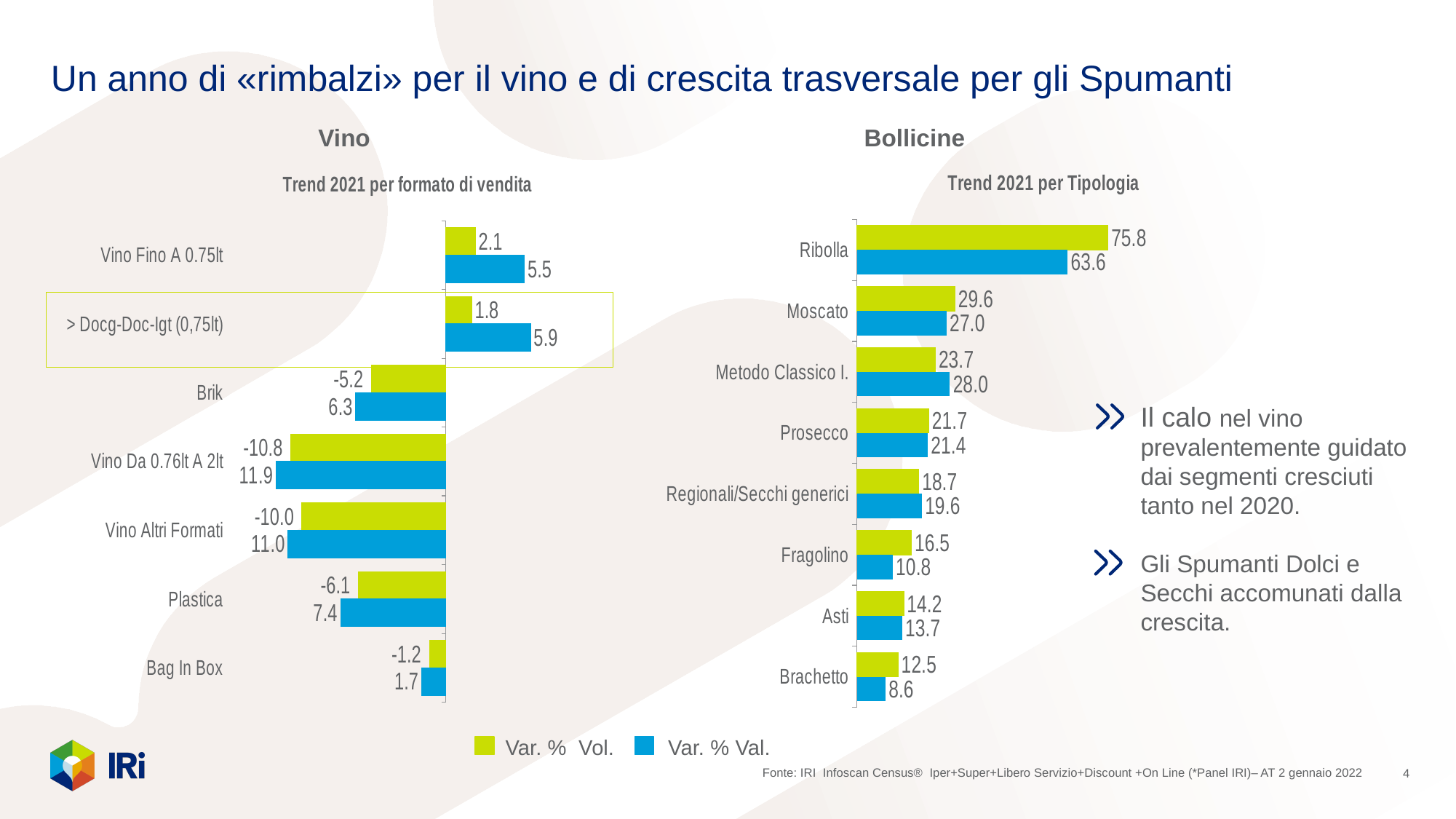
In the Bollicine chart, which is larger for Metodo Classico I.: Var. % Vol. or Var. % Val.? Var. % Val. How many series does the legend list? 2 In the Vino chart (Trend 2021 per formato di vendita), what is the Var. % Vol. value for Brik? -5.2 In the Vino chart, what is the Var. % Val. value for > Docg-Doc-Igt (0,75lt)? 5.9 In the Bollicine chart, what is the difference between the Var. % Vol. and Var. % Val. values for Ribolla? 12.2 How many categories are shown in the Vino chart? 7 In the Bollicine chart (Trend 2021 per Tipologia), what is the Var. % Vol. value for Prosecco? 21.7 In the Vino chart, which category has the lowest Var. % Vol. value? Vino Da 0.76lt A 2lt In the Bollicine chart, which category has the highest Var. % Vol. value? Ribolla In the Bollicine chart, what is the Var. % Val. value for Brachetto? 8.6 How many categories are shown in the Bollicine chart? 8 What type of chart is the Vino chart? Bar chart